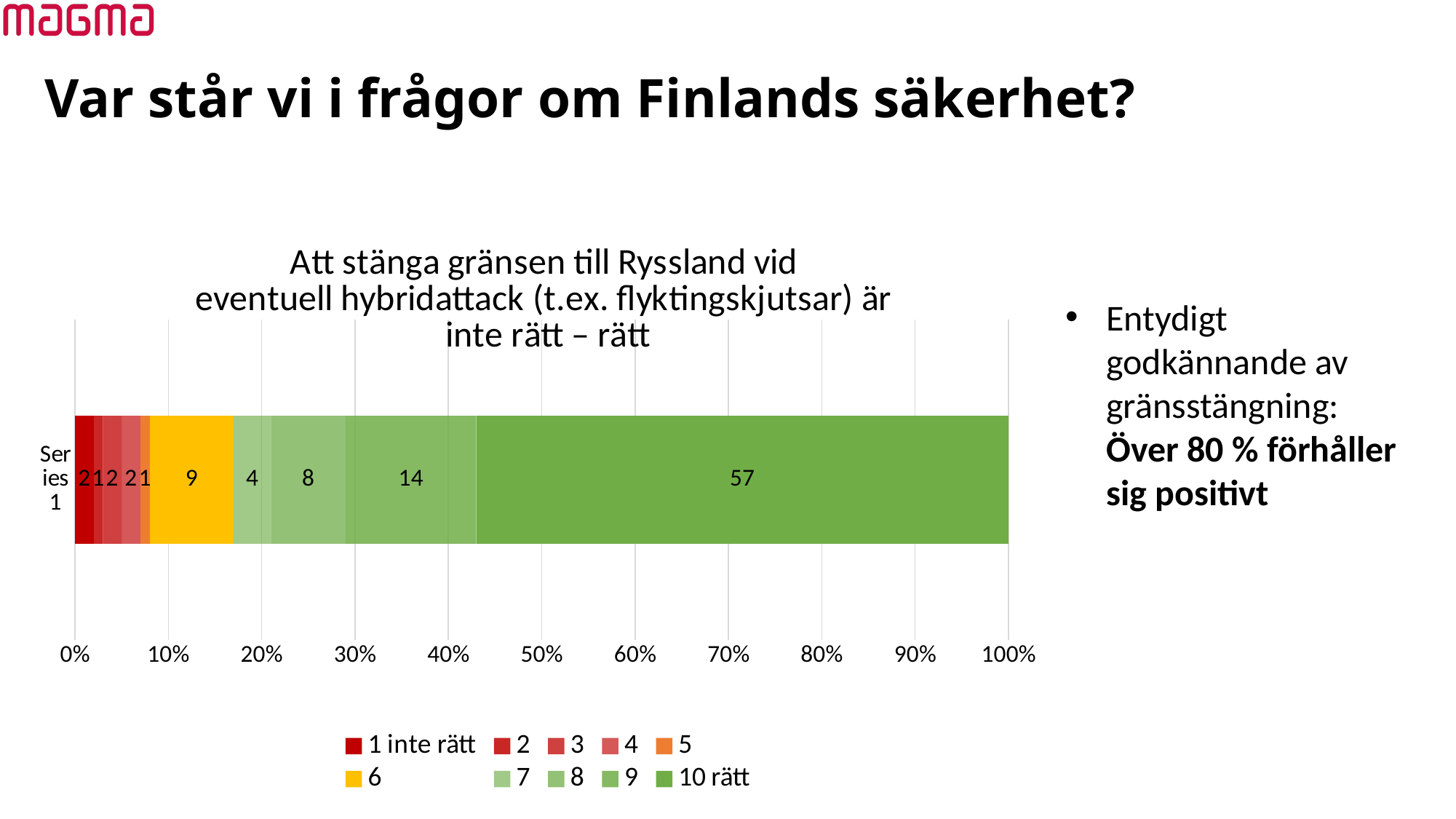
What is the value of the '8' segment? 8 What is the title of the chart? Att stänga gränsen till Ryssland vid eventuell hybridattack (t.ex. flyktingskjutsar) är inte rätt – rätt What is the difference between the '10 rätt' segment and the '9' segment? 43 Which series has the largest segment in the bar? 10 rätt Which is larger, the '6' segment or the '8' segment? 6 What is the value of the '6' segment? 9 What is the value of the '9' segment? 14 How many bars (categories) does the chart have? 1 What is the value of the '7' segment? 4 How many series does the legend list? 10 What kind of chart is shown on the slide? Stacked bar chart What is the value of the '10 rätt' segment? 57